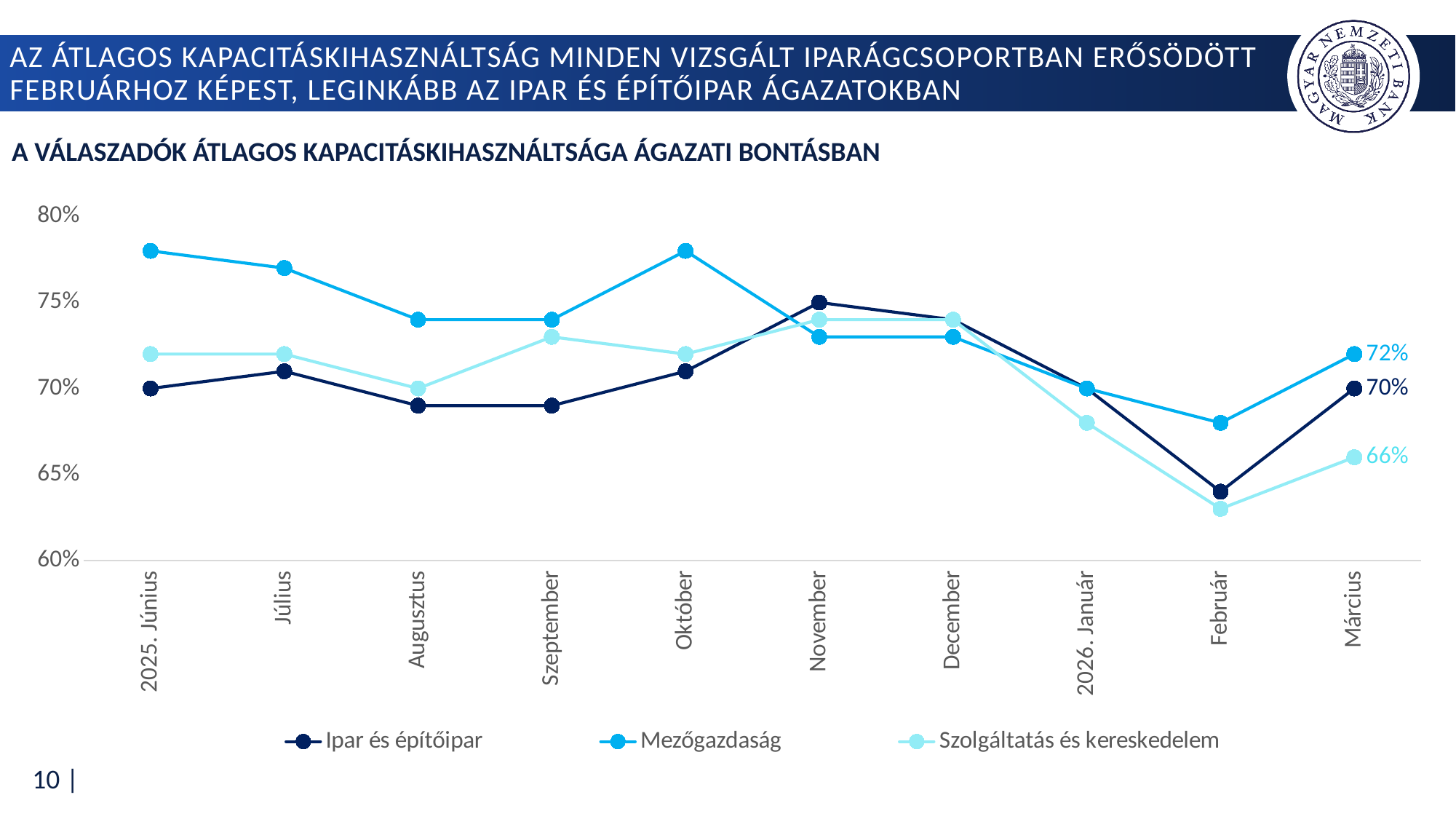
Does the Ipar és építőipar line rise or fall from Február to Március? rise What is the value for Mezőgazdaság in Március? 72% What is the value for Szolgáltatás és kereskedelem in Március? 66% Is the value for Mezőgazdaság in 2025. Június greater or less than 75%? greater Is the value for Ipar és építőipar in Február greater or less than 65%? less What kind of chart is shown on the slide? line chart How many series does the legend list? 3 How many months are shown on the x axis? 10 In Március, which is larger: Ipar és építőipar or Szolgáltatás és kereskedelem? Ipar és építőipar What is the value for Ipar és építőipar in Március? 70% Which series has the highest value in Március? Mezőgazdaság In Március, how much higher is Mezőgazdaság than Szolgáltatás és kereskedelem? 6 percentage points